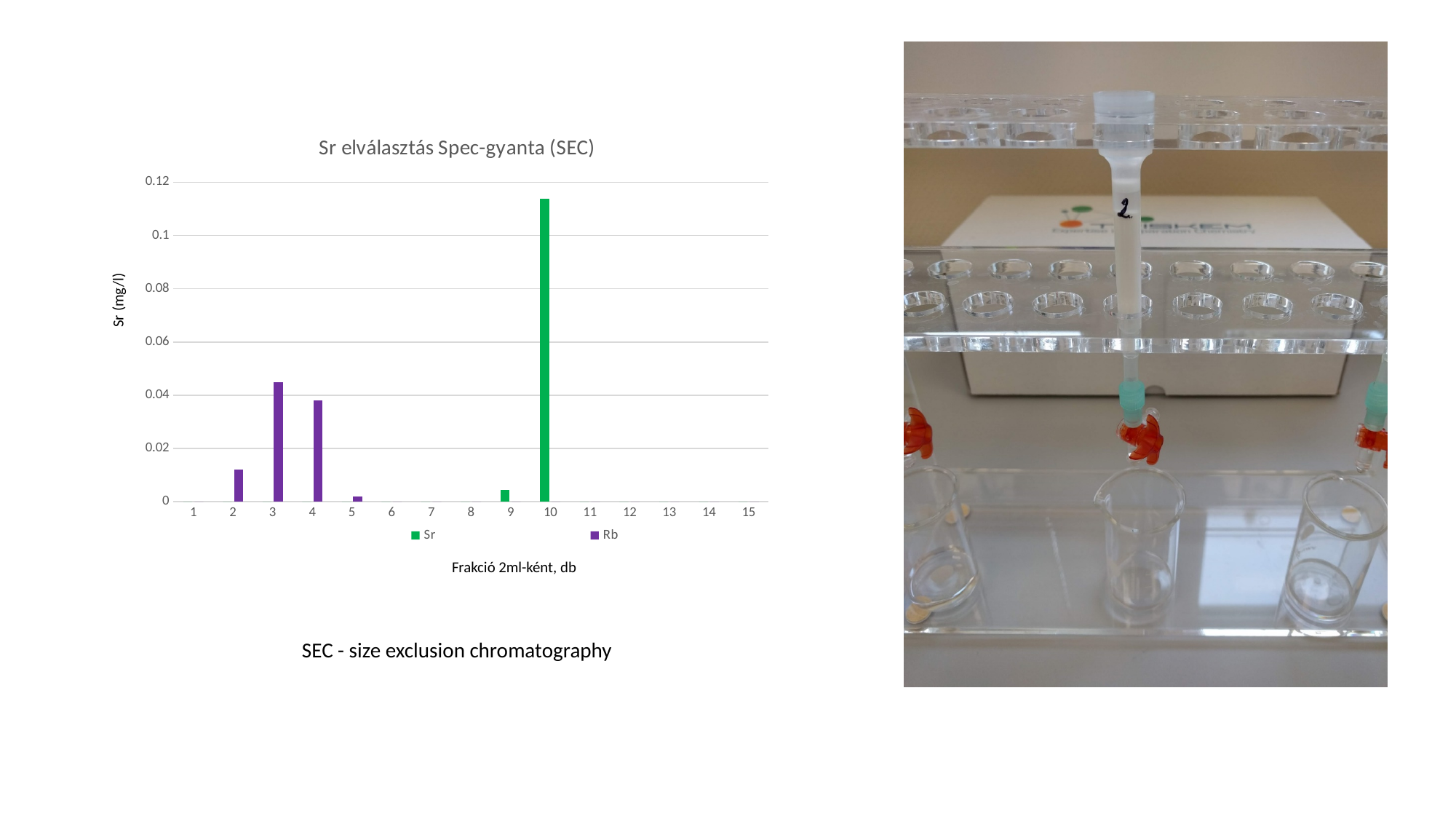
What kind of chart is shown on the slide? bar chart What is the label of the y axis of the chart? Sr (mg/l) Is the Rb value at fraction 2 greater or less than 0.02? less How many fraction categories are shown on the x axis of the chart? 15 What is the title of the chart? Sr elválasztás Spec-gyanta (SEC) Which is larger: the Rb value at fraction 3 or the Rb value at fraction 5? Rb at fraction 3 Is the Sr value at fraction 10 greater or less than 0.1? greater Is the Rb value at fraction 4 greater or less than 0.02? greater At which fraction is the Sr value highest? 10 At which fraction is the Rb value highest? 3 How many series does the chart legend list? 2 Which is larger: the Sr value at fraction 10 or the Rb value at fraction 3? Sr at fraction 10